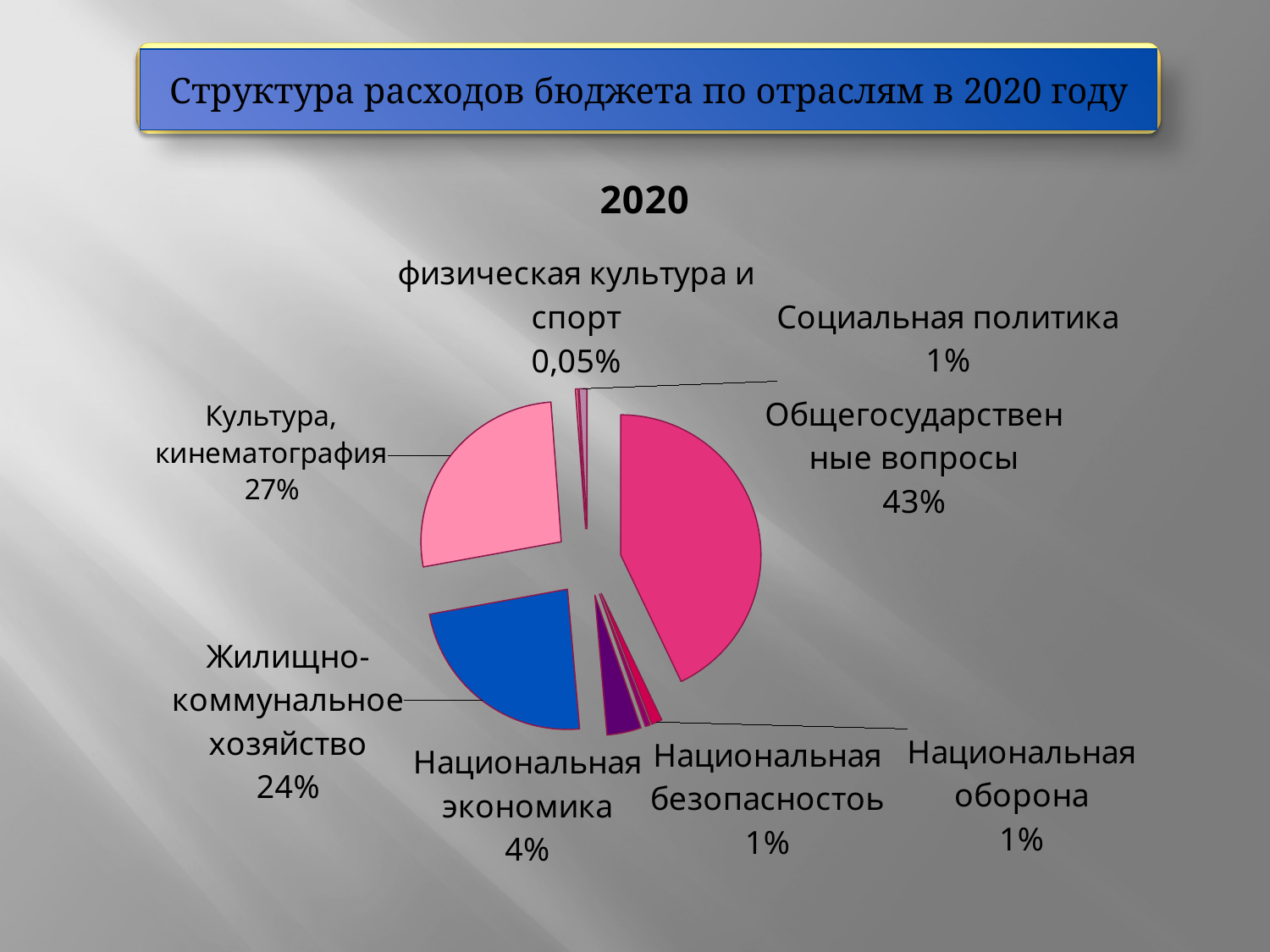
What share of the pie does Жилищно-коммунальное хозяйство have? 24% What share of the pie does Национальная экономика have? 4% Which is larger, the share of Культура, кинематография or the share of Жилищно-коммунальное хозяйство? Культура, кинематография Which category has the smallest slice of the pie? физическая культура и спорт What share of the pie does Общегосударственные вопросы have? 43% What is the difference between the shares of Общегосударственные вопросы and Культура, кинематография? 16% Which category has the largest slice of the pie? Общегосударственные вопросы How many categories are shown in the pie chart? 8 What is the title shown above the pie chart? 2020 What kind of chart is shown on the slide? pie chart